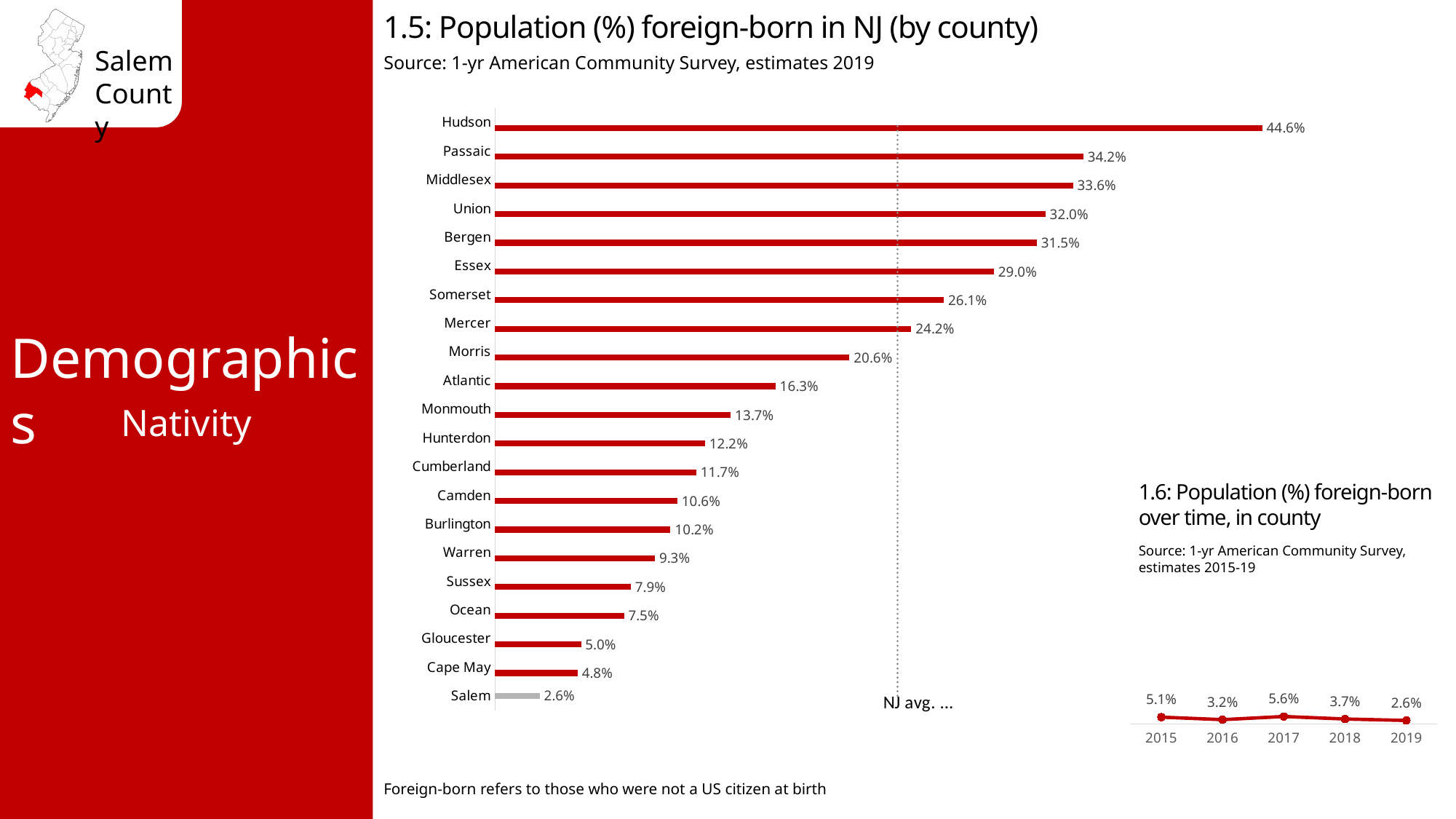
In chart 1.6 (Population (%) foreign-born over time, in county), how many years are plotted? 5 What kind of chart is chart 1.6 (Population (%) foreign-born over time, in county)? Line chart In chart 1.5 (Population (%) foreign-born in NJ by county), what is the value for Salem? 2.6% In chart 1.6 (Population (%) foreign-born over time, in county), which year has the lowest value? 2019 In chart 1.5 (Population (%) foreign-born in NJ by county), how many counties are shown? 21 In chart 1.6 (Population (%) foreign-born over time, in county), what is the value for 2017? 5.6% What kind of chart is chart 1.5 (Population (%) foreign-born in NJ by county)? Bar chart In chart 1.5 (Population (%) foreign-born in NJ by county), which county has the highest value? Hudson In chart 1.5 (Population (%) foreign-born in NJ by county), which county has the lowest value? Salem In chart 1.5 (Population (%) foreign-born in NJ by county), which is larger, Camden or Burlington? Camden In chart 1.5 (Population (%) foreign-born in NJ by county), what is the difference between Passaic and Middlesex? 0.6% In chart 1.5 (Population (%) foreign-born in NJ by county), what is the value for Hudson? 44.6%